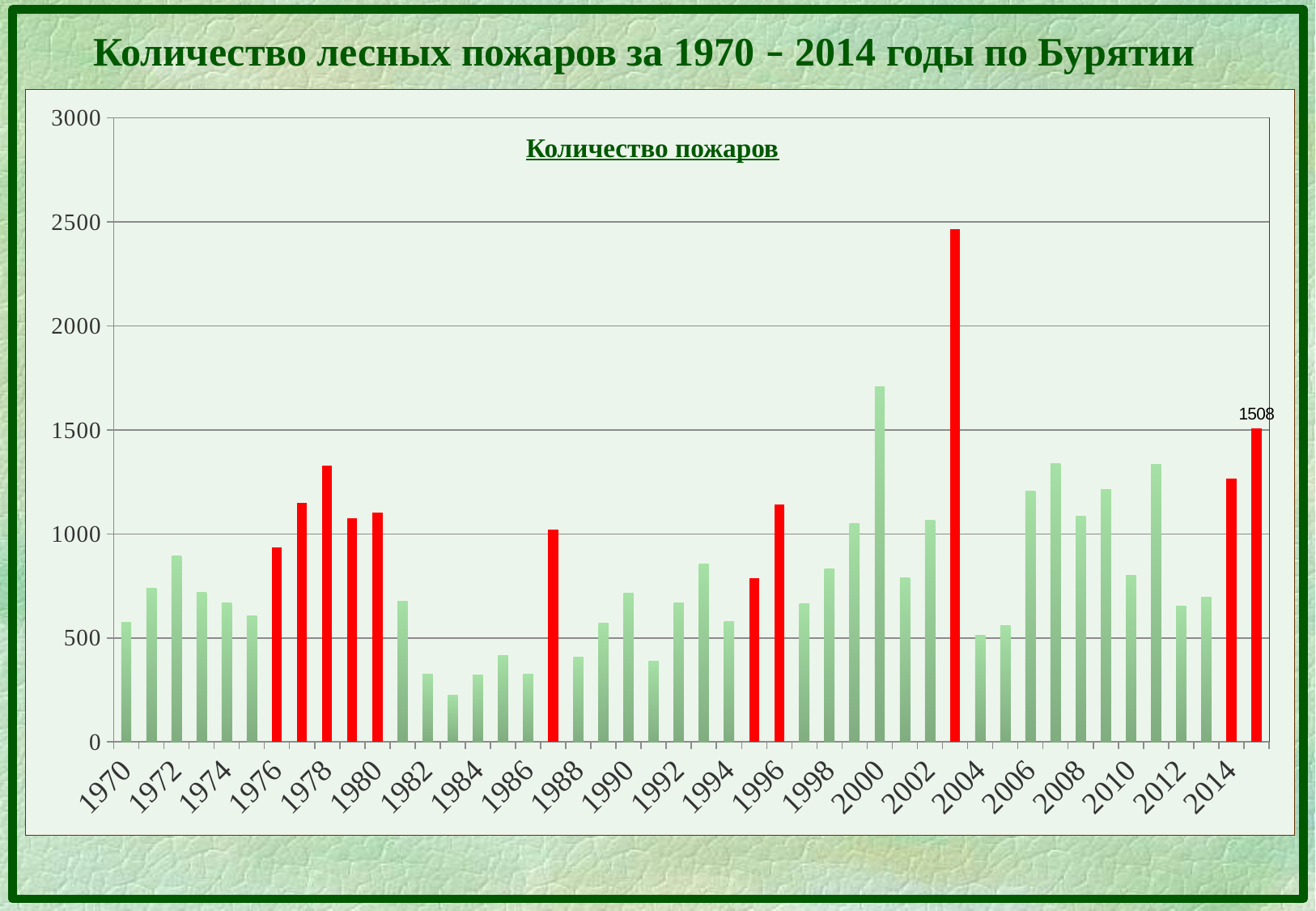
Is the value for 2000 greater or less than 1500? greater What kind of chart is shown on the slide? bar chart What is the title of the chart on the slide? Количество лесных пожаров за 1970 – 2014 годы по Бурятии Which year has more fires, 2003 or 2000? 2003 Which year has the highest number of fires? 2003 Is the value for 1983 greater or less than 500? less Which year has the lowest number of fires? 1983 Do the values rise or fall from 1981 to 1983? fall What value is printed as a data label on the chart? 1508 Is the value for 2003 greater or less than 2000? greater